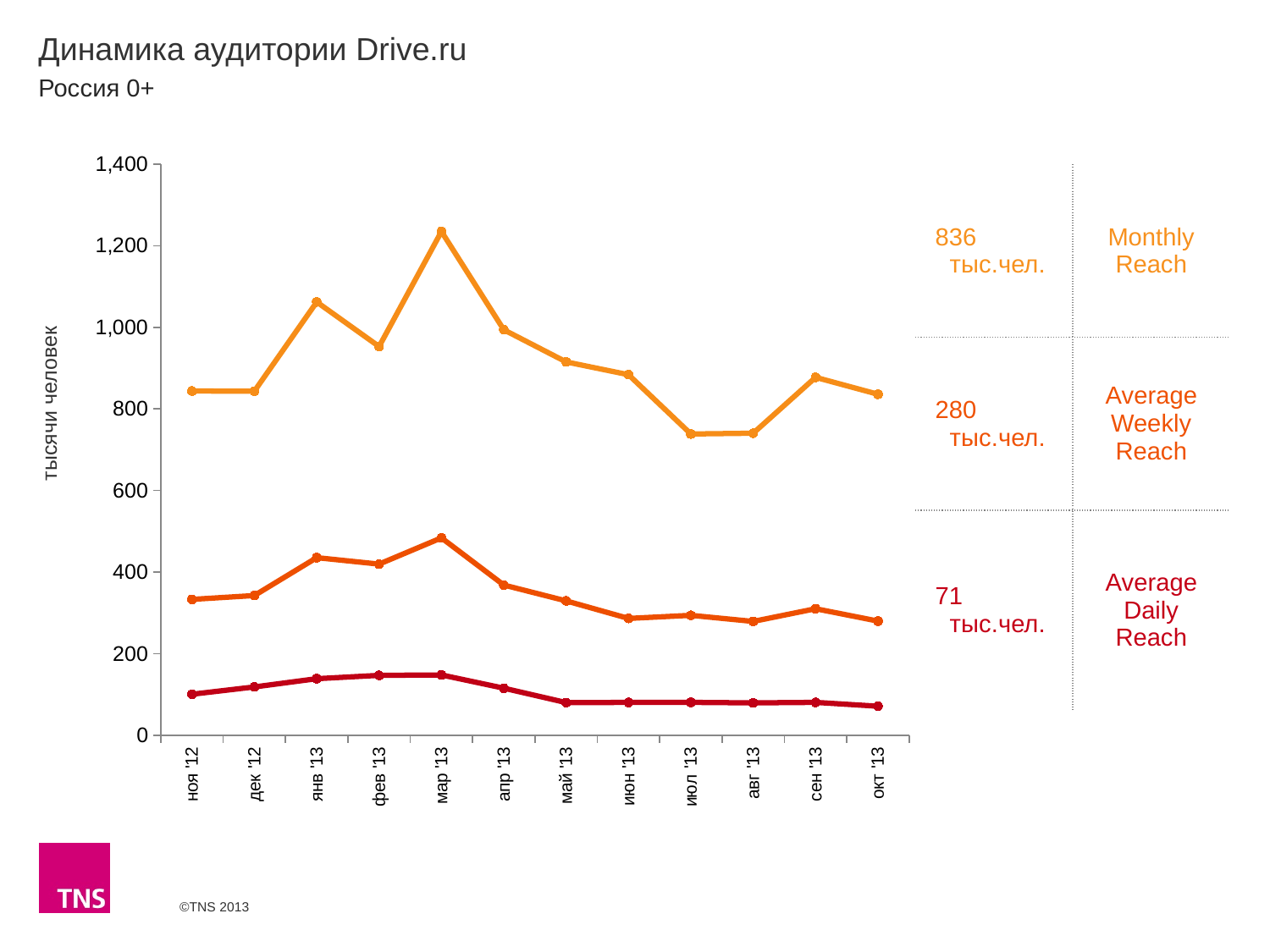
Is the Monthly Reach value for июл '13 greater or less than 800? less In which month does the Average Weekly Reach line reach its highest point? мар '13 Which is higher for Monthly Reach: янв '13 or фев '13? янв '13 How many time points are plotted along the x axis? 12 What Average Weekly Reach value is printed in the panel to the right of the chart? 280 тыс.чел. Is the Monthly Reach value for мар '13 greater or less than 1,000? greater What type of chart is shown on the slide? line chart In which month does the Monthly Reach line reach its highest point? мар '13 What is the label on the y axis? тысячи человек What Average Daily Reach value is printed in the panel to the right of the chart? 71 тыс.чел. How many series are listed in the panel to the right of the chart? 3 What Monthly Reach value is printed in the panel to the right of the chart? 836 тыс.чел.